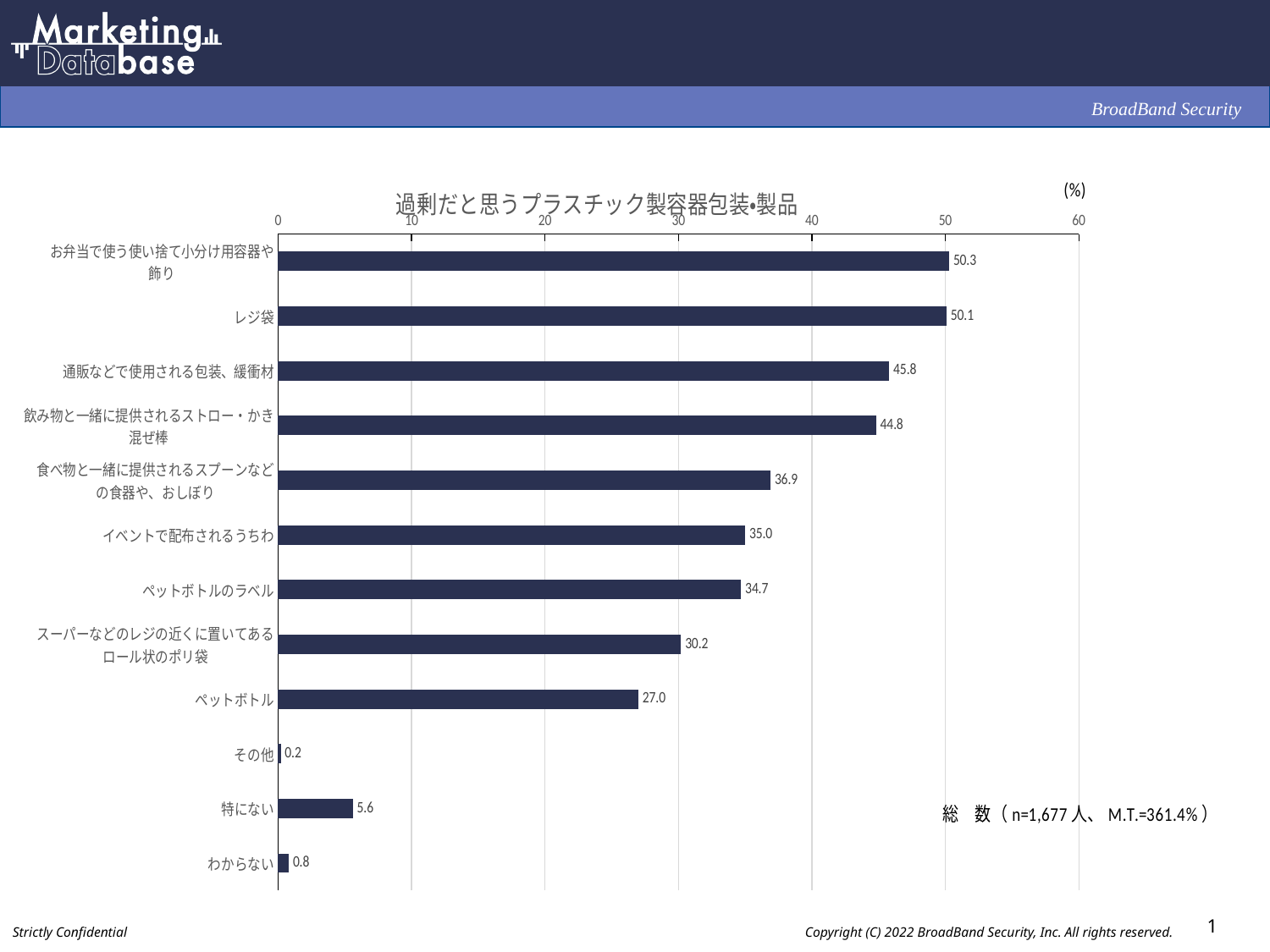
How many categories are shown in the chart? 12 Which category has the highest value? お弁当で使う使い捨て小分け用容器や飾り What kind of chart is shown on the slide? bar chart Which category has the lowest value? その他 Is the value for 食べ物と一緒に提供されるスプーンなどの食器や、おしぼり greater or less than 40? less Which is larger, the value for ペットボトルのラベル or the value for スーパーなどのレジの近くに置いてあるロール状のポリ袋? ペットボトルのラベル What is the value for ペットボトル? 27.0 What is the value for レジ袋? 50.1 What is the difference between the values for 通販などで使用される包装、緩衝材 and 飲み物と一緒に提供されるストロー・かき混ぜ棒? 1.0 What is the value for イベントで配布されるうちわ? 35.0 What is the sample size (n) shown on the slide? 1,677 What is the title of the chart? 過剰だと思うプラスチック製容器包装•製品